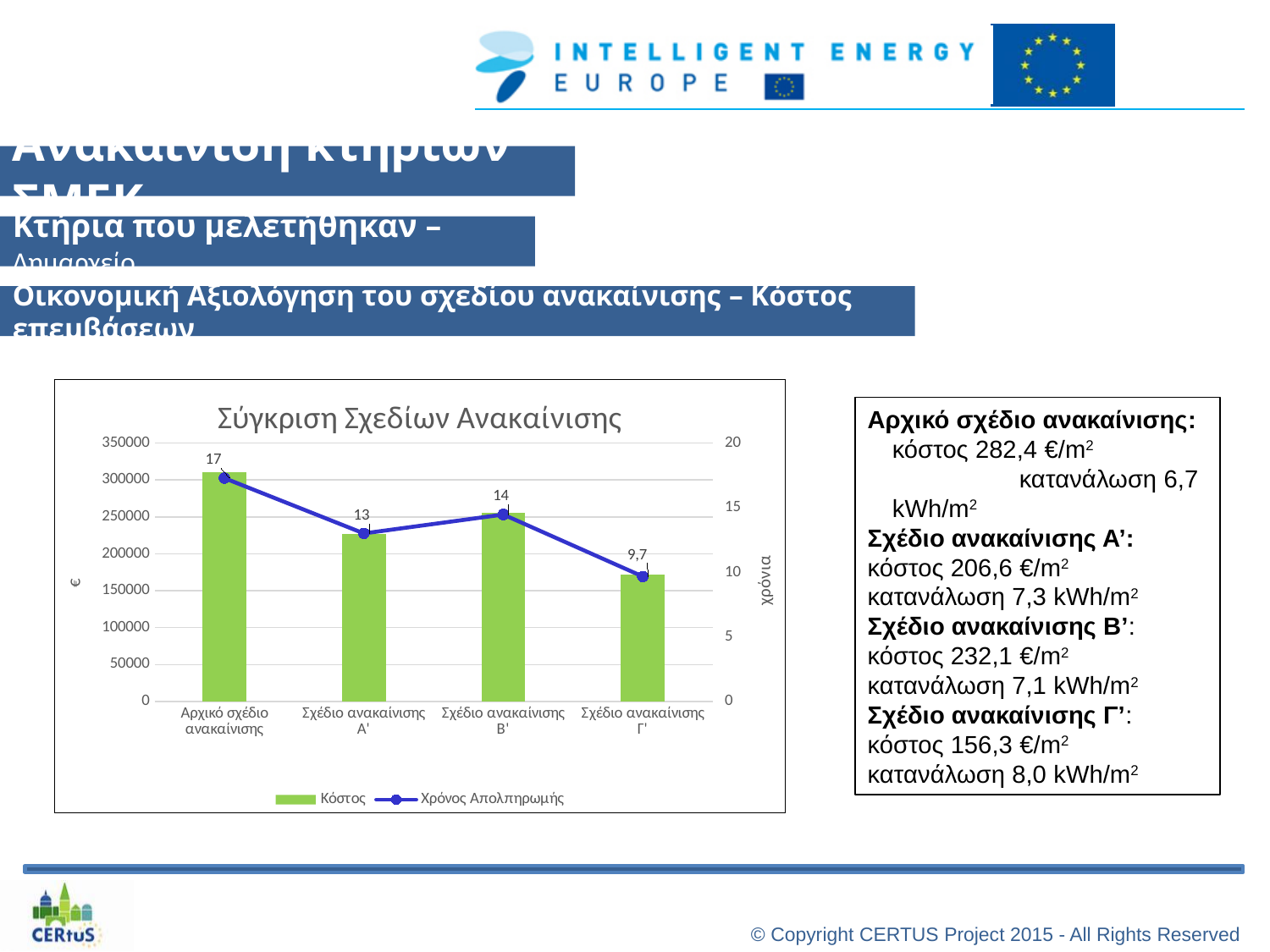
Is the cost (Κόστος) for Αρχικό σχέδιο ανακαίνισης greater or less than 300000? greater What is the payback time (Χρόνος Απολπηρωμής) shown for Σχέδιο ανακαίνισης Γ'? 9,7 Which renovation plan has the lowest cost (Κόστος) bar? Σχέδιο ανακαίνισης Γ' Which has the larger payback time, Σχέδιο ανακαίνισης Α' or Σχέδιο ανακαίνισης Β'? Σχέδιο ανακαίνισης Β' How many renovation plans are shown on the x axis of the chart? 4 What is the title of the chart? Σύγκριση Σχεδίων Ανακαίνισης What is the payback time (Χρόνος Απολπηρωμής) shown for Σχέδιο ανακαίνισης Β'? 14 What is the difference in payback time between Αρχικό σχέδιο ανακαίνισης and Σχέδιο ανακαίνισης Α'? 4 How many series does the chart legend list? 2 Is the cost (Κόστος) for Σχέδιο ανακαίνισης Γ' greater or less than 200000? less What is the payback time (Χρόνος Απολπηρωμής) shown for Αρχικό σχέδιο ανακαίνισης? 17 Which renovation plan has the highest payback time (Χρόνος Απολπηρωμής)? Αρχικό σχέδιο ανακαίνισης